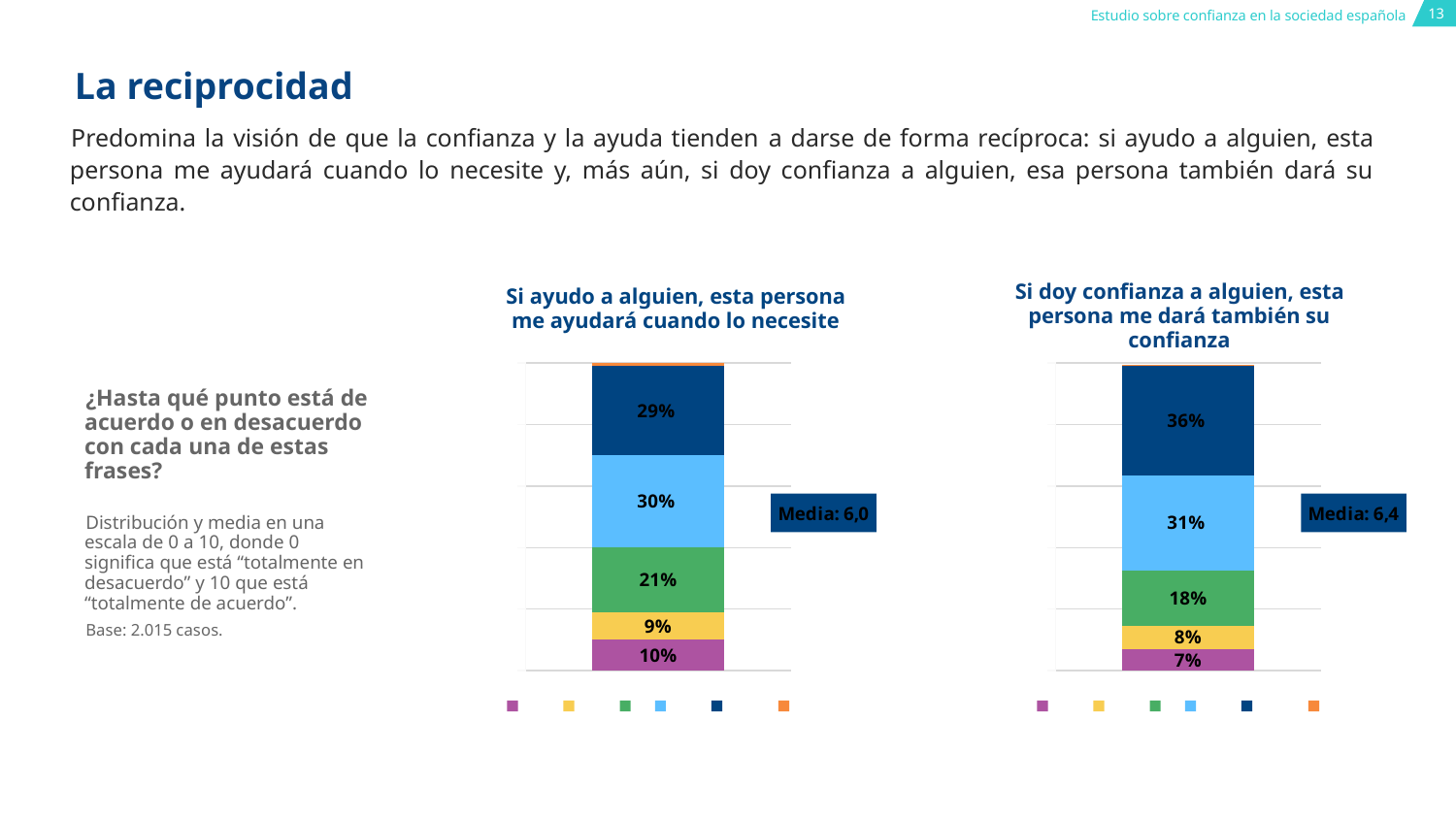
In the chart titled "Si doy confianza a alguien, esta persona me dará también su confianza", what percentage is shown on the green segment? 18% What kind of chart is used for "Si ayudo a alguien, esta persona me ayudará cuando lo necesite"? Stacked bar chart In the chart titled "Si ayudo a alguien, esta persona me ayudará cuando lo necesite", what percentage is shown on the light blue segment? 30% What is the mean (Media) shown next to the chart titled "Si ayudo a alguien, esta persona me ayudará cuando lo necesite"? Media: 6,0 In the chart titled "Si doy confianza a alguien, esta persona me dará también su confianza", what percentage is shown on the dark blue segment? 36% In the chart titled "Si ayudo a alguien, esta persona me ayudará cuando lo necesite", what percentage is shown on the purple segment at the bottom of the bar? 10% Which chart has the larger light blue segment: "Si ayudo a alguien, esta persona me ayudará cuando lo necesite" or "Si doy confianza a alguien, esta persona me dará también su confianza"? Si doy confianza a alguien, esta persona me dará también su confianza (31%) What is the difference between the dark blue segment in the right chart (36%) and the dark blue segment in the left chart (29%)? 7 percentage points What is the mean (Media) shown next to the chart titled "Si doy confianza a alguien, esta persona me dará también su confianza"? Media: 6,4 In the chart titled "Si doy confianza a alguien, esta persona me dará también su confianza", what percentage is shown on the yellow segment? 8% In the chart titled "Si ayudo a alguien, esta persona me ayudará cuando lo necesite", what percentage is shown on the dark blue segment? 29% In the chart titled "Si doy confianza a alguien, esta persona me dará también su confianza", which labelled segment has the largest percentage? The dark blue segment (36%)